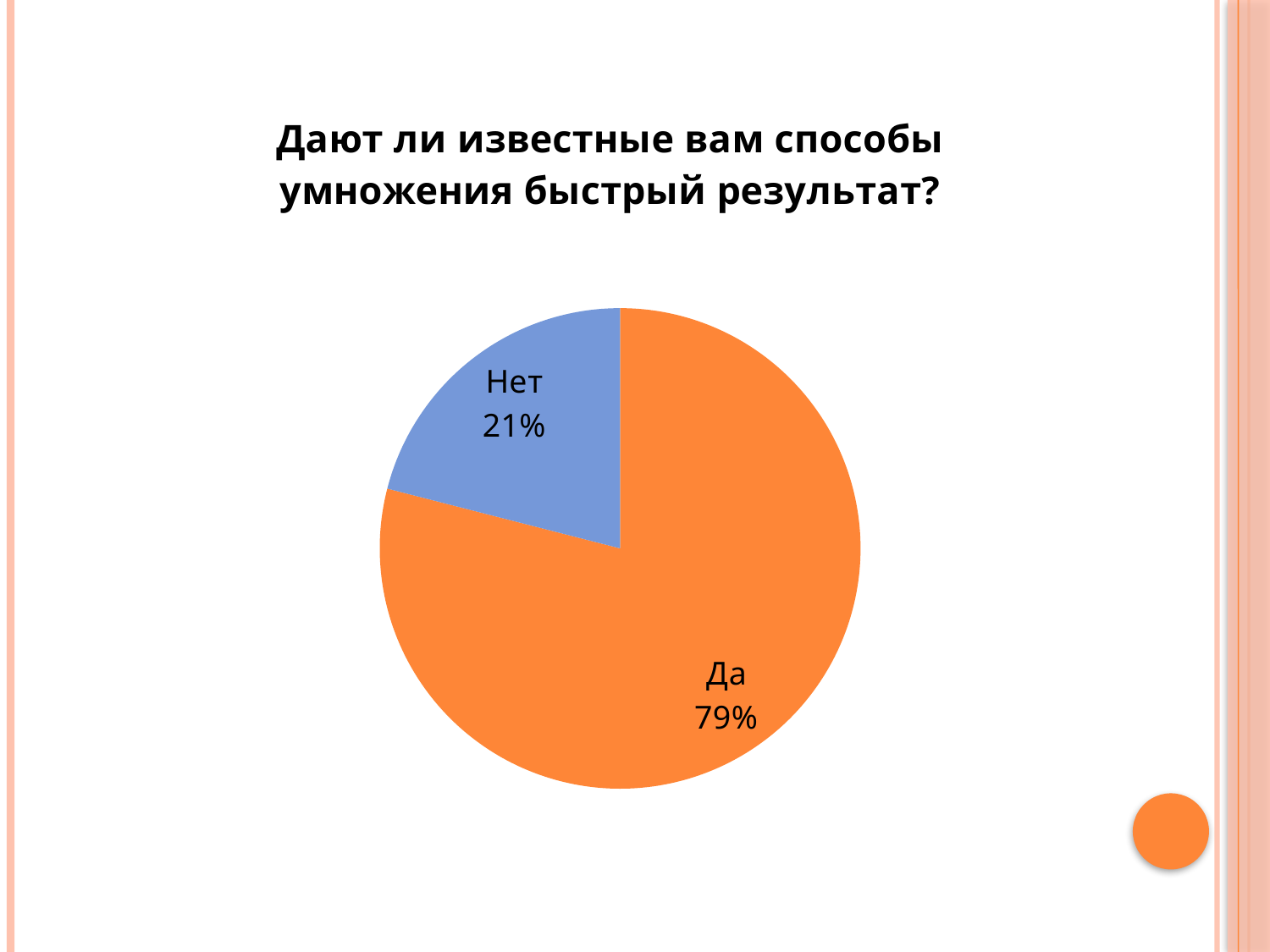
What colour is the "Нет" slice? blue Which is larger, the "Да" slice or the "Нет" slice? Да What is the difference between the "Да" and "Нет" shares? 58% What share of the pie does "Да" have? 79% How many slices does the pie chart have? 2 What is the total of the two slices' percentages? 100% Which slice is the largest? Да What is the title of the chart? Дают ли известные вам способы умножения быстрый результат? What kind of chart is shown on the slide? pie chart Which slice is the smallest? Нет What share of the pie does "Нет" have? 21%